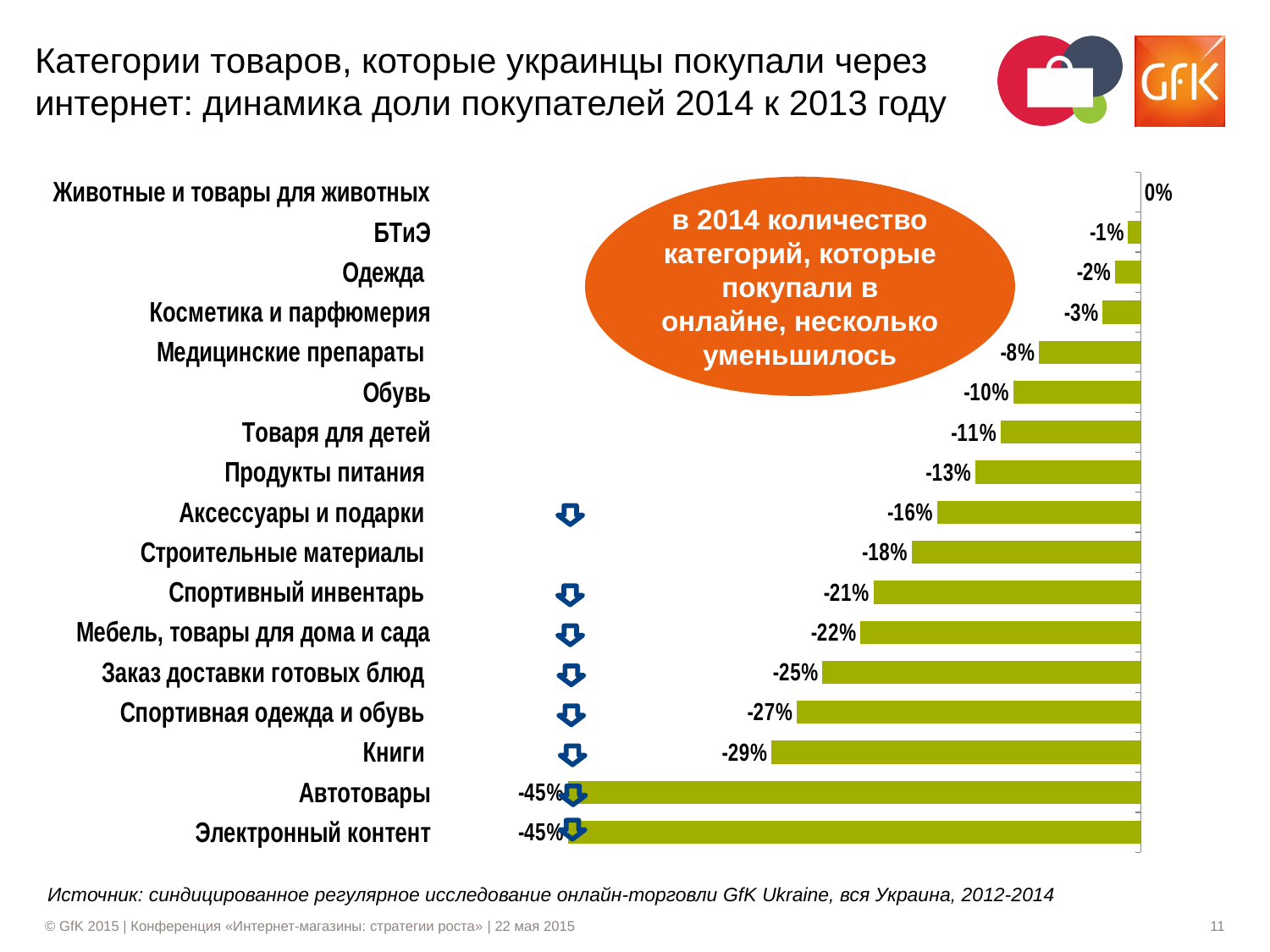
What is the difference between the values for Аксессуары и подарки and Мебель, товары для дома и сада? 6 percentage points What is the difference between the values for Обувь and Книги? 19 percentage points What is the value shown for Продукты питания? -13% What is the value shown for Книги? -29% Which category has the highest value in the chart? Животные и товары для животных Which has the larger value, Одежда or Спортивный инвентарь? Одежда What is the value shown for Медицинские препараты? -8% Which two categories share the lowest value of -45%? Автотовары and Электронный контент How many categories are plotted in the chart? 17 What kind of chart is shown on the slide? Bar chart What does the orange callout on the chart say? в 2014 количество категорий, которые покупали в онлайне, несколько уменьшилось What is the value shown for Заказ доставки готовых блюд? -25%